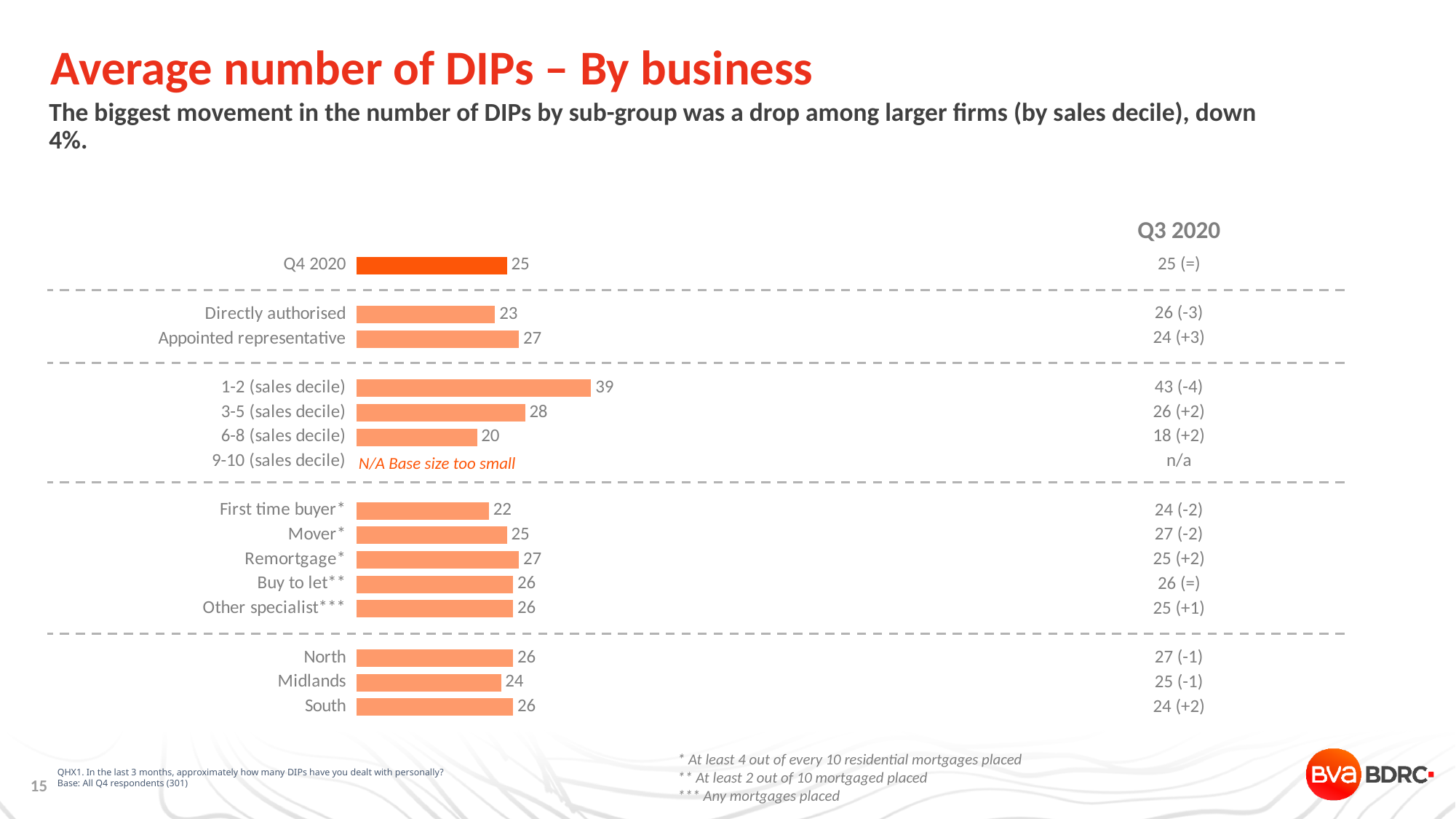
Which is larger, the value for North or the value for Midlands? North Which plotted category has the lowest average number of DIPs? 6-8 (sales decile) How many bars are plotted in the chart? 14 Which is larger, the value for Remortgage or the value for First time buyer? Remortgage Why is there no bar for 9-10 (sales decile)? N/A Base size too small What is the value shown for Midlands? 24 What kind of chart is shown on the slide? Bar chart What is the value shown for the 1-2 (sales decile) bar? 39 What is the average number of DIPs for Directly authorised firms in Q4 2020? 23 What is the difference between the values for Appointed representative and Directly authorised? 4 Which category has the highest average number of DIPs? 1-2 (sales decile) What is the difference between the values for 1-2 (sales decile) and 6-8 (sales decile)? 19